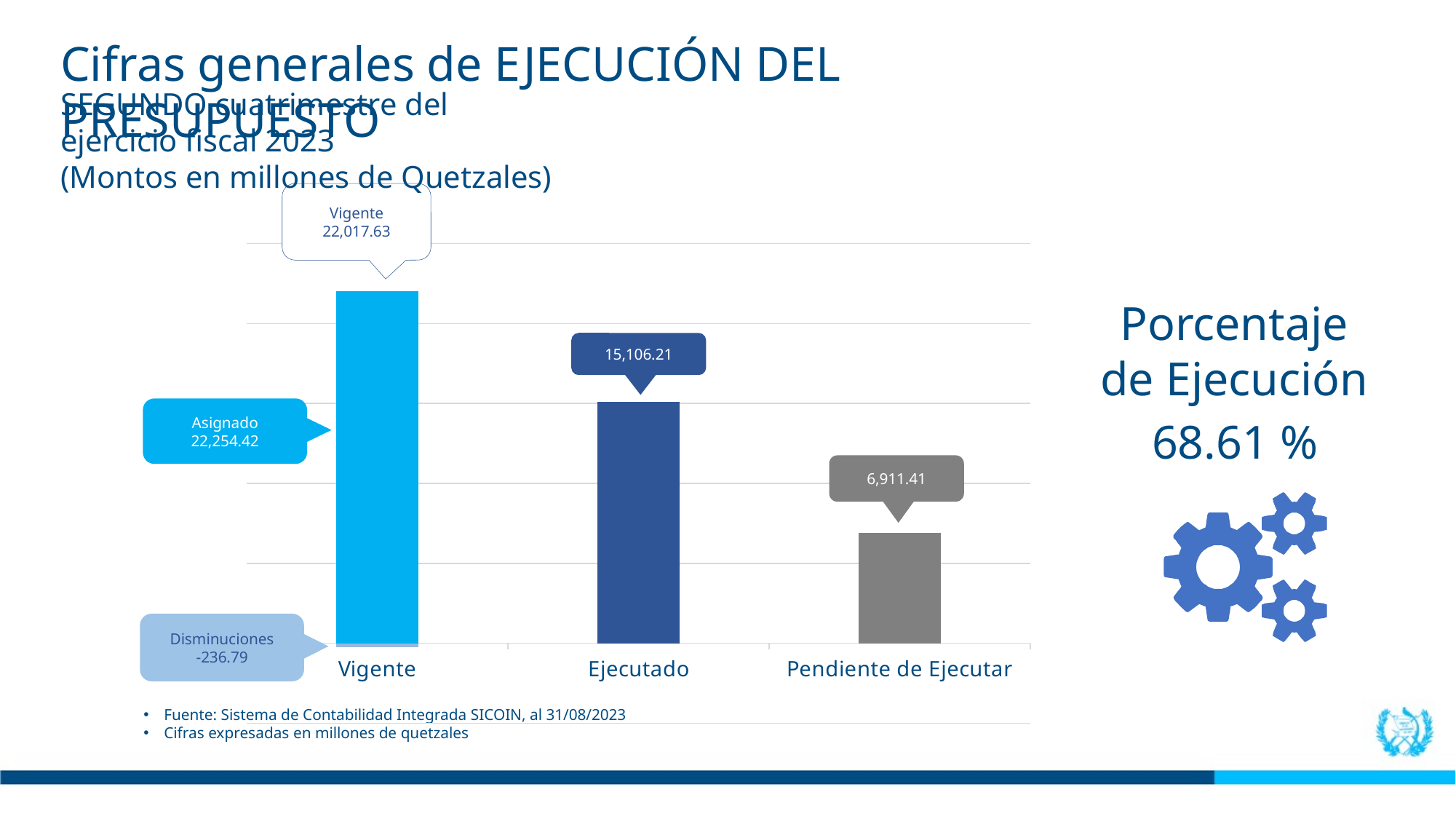
What value does the Asignado callout show? 22,254.42 Which category has the lowest bar? Pendiente de Ejecutar What is the value of the Vigente bar? 22,017.63 What is the difference between the Ejecutado and Pendiente de Ejecutar values? 8,194.80 How many categories are shown on the x axis of the chart? 3 What is the value shown for Ejecutado? 15,106.21 Do the bar values rise or fall from left to right across the x axis? Fall What is the value shown for Pendiente de Ejecutar? 6,911.41 What kind of chart is shown on the slide? Bar chart Which is larger, the Ejecutado bar or the Pendiente de Ejecutar bar? Ejecutado What value does the Disminuciones callout show? -236.79 Which category has the highest bar? Vigente